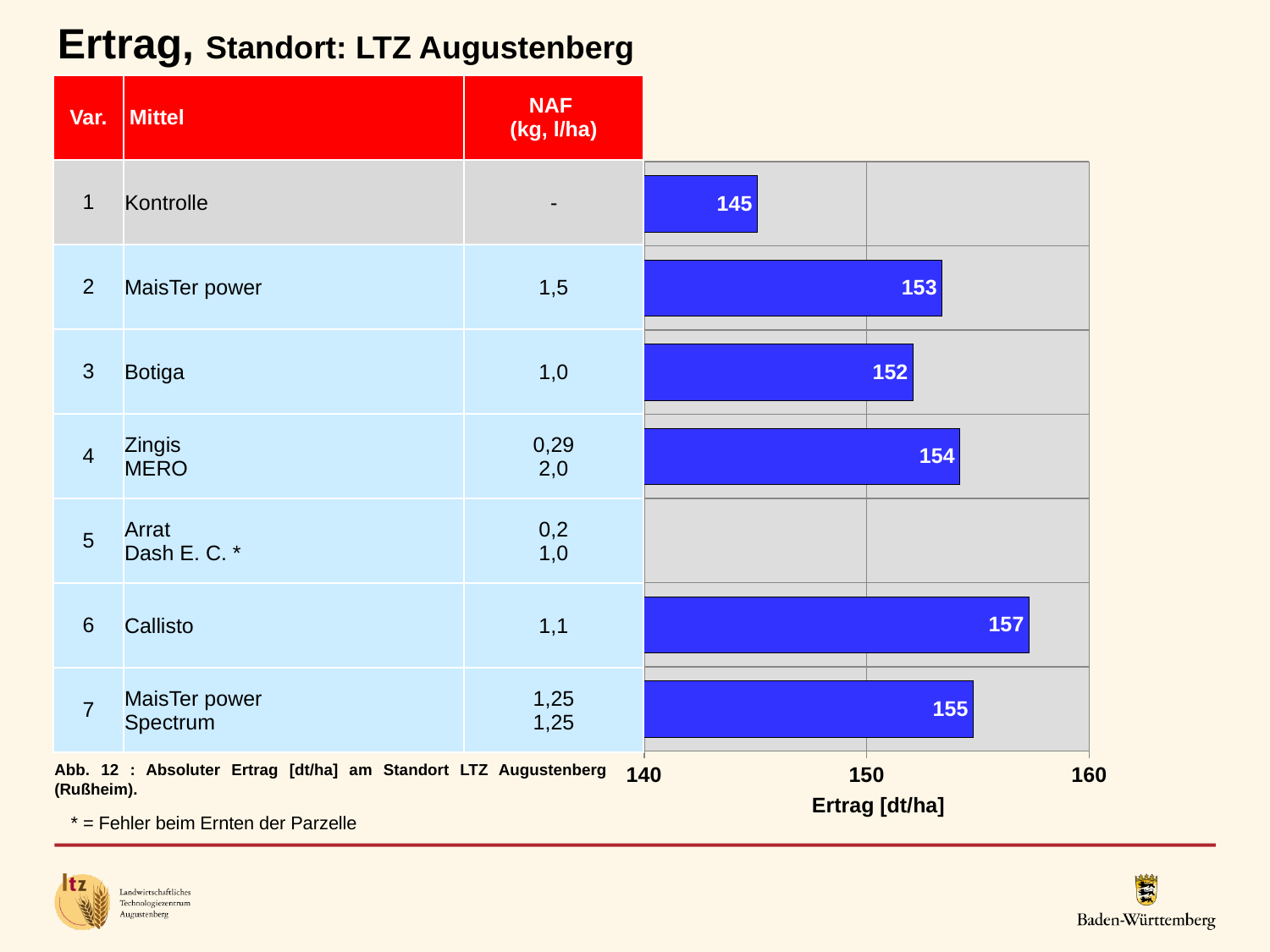
What is the difference in Ertrag between Callisto and Kontrolle? 12 What is the Ertrag value for the Zingis + MERO variant (Var. 4)? 154 What kind of chart is shown on the slide? bar chart What is the Ertrag value for Kontrolle (Var. 1)? 145 Which has a higher Ertrag, MaisTer power (Var. 2) or MaisTer power + Spectrum (Var. 7)? MaisTer power + Spectrum What is the Ertrag value for Botiga (Var. 3)? 152 What is the Ertrag value for Callisto (Var. 6)? 157 What is the label of the horizontal axis of the chart? Ertrag [dt/ha] Which variant with a plotted bar has the lowest Ertrag? Kontrolle How many variants have a bar plotted in the chart? 6 Which variant has the highest Ertrag? Callisto Is the Ertrag value for Kontrolle greater or less than 150? less